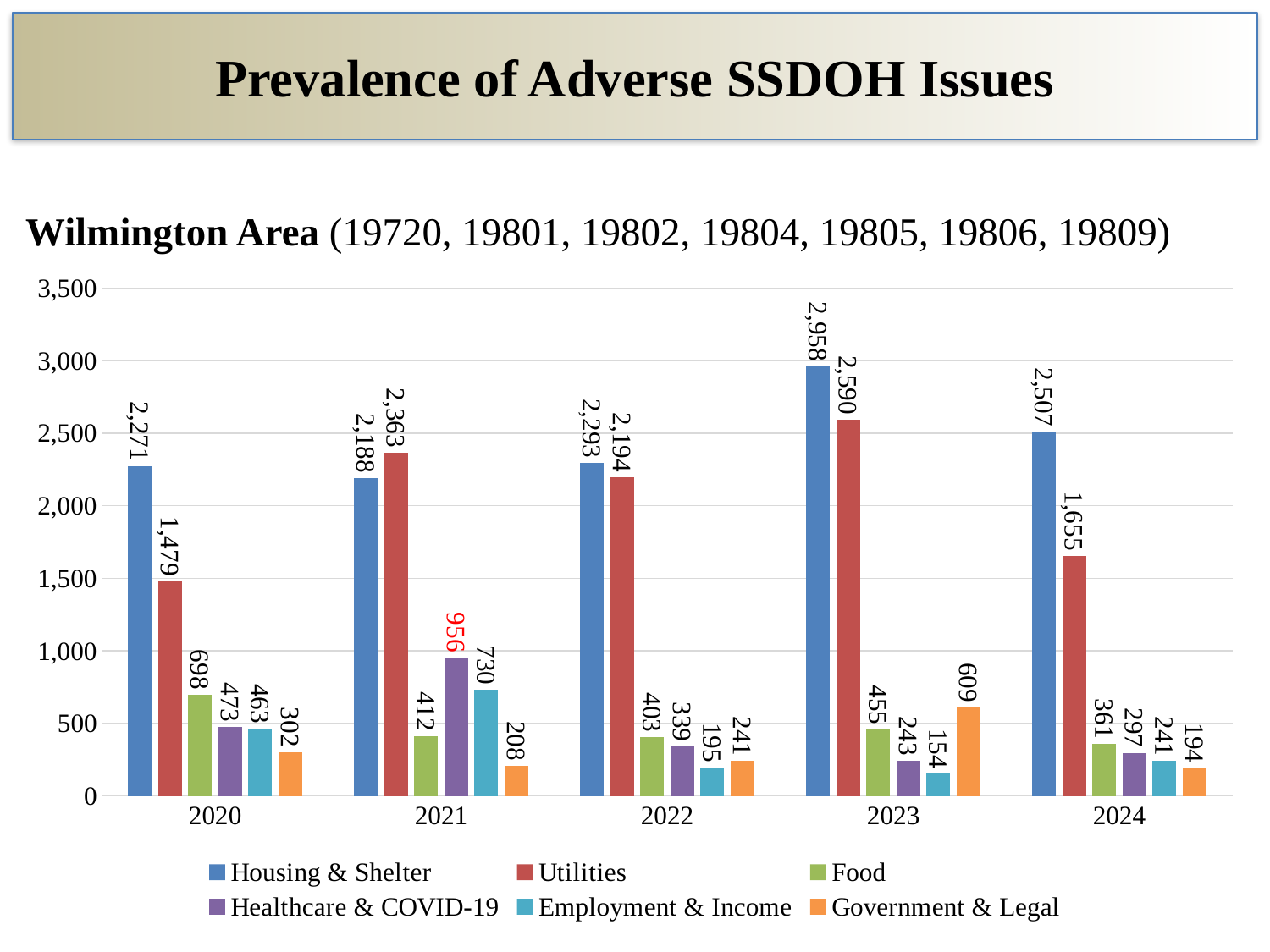
What is the value for Utilities in 2020? 1,479 How many years are shown on the x axis? 5 In which year is the Housing & Shelter value highest? 2023 What is the value for Healthcare & COVID-19 in 2021? 956 What kind of chart is shown on the slide? Bar chart What is the value for Housing & Shelter in 2023? 2,958 In 2021, which is larger: Housing & Shelter or Utilities? Utilities What is the value for Government & Legal in 2023? 609 How many series does the legend list? 6 What is the difference between the Housing & Shelter and Utilities values in 2024? 852 Does the Employment & Income value rise or fall from 2021 to 2023? Fall Which series has the lowest value in 2023? Employment & Income